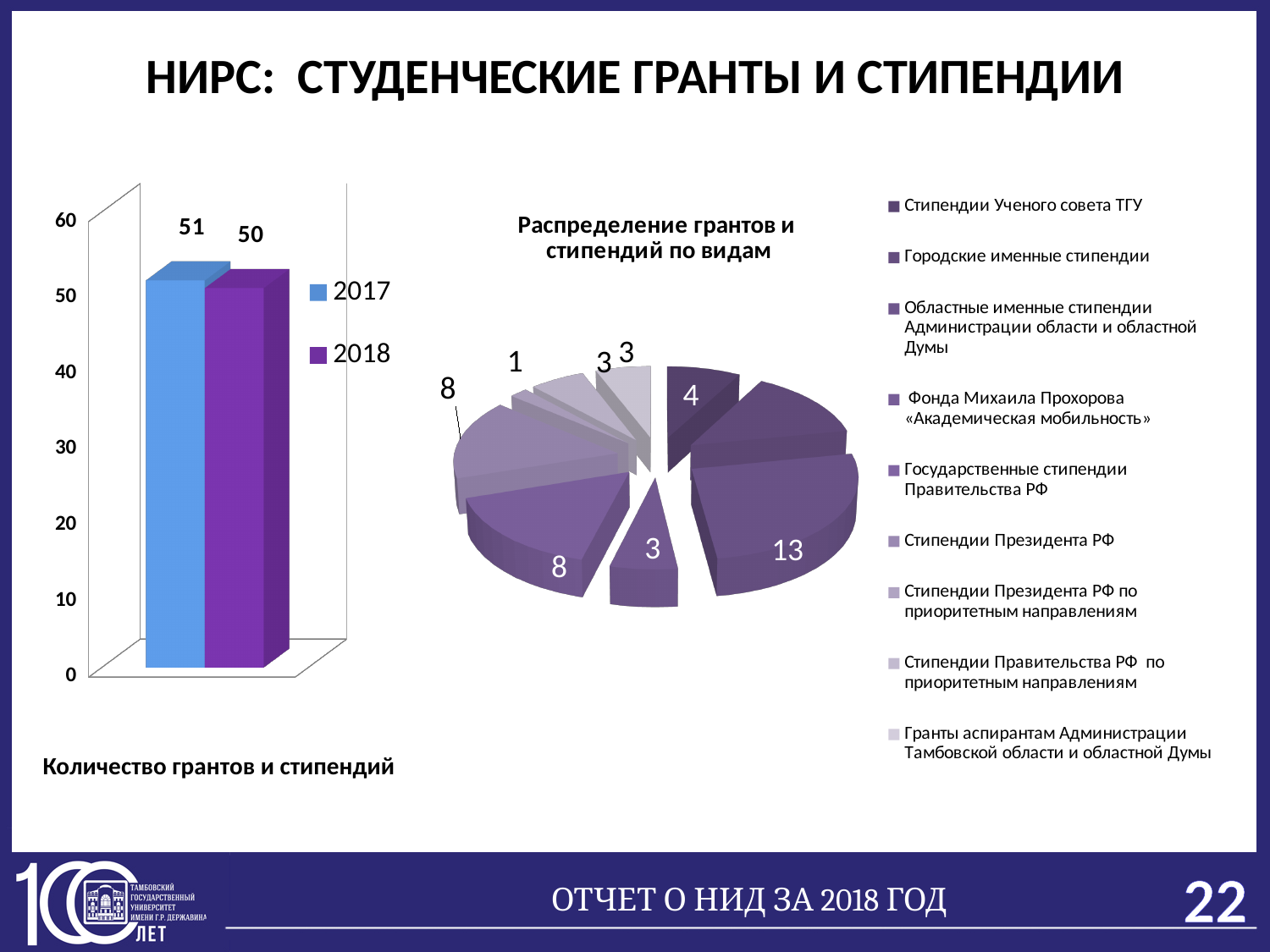
What kind of chart is 'Распределение грантов и стипендий по видам'? Pie chart On the left bar chart, which year has the higher value, 2017 or 2018? 2017 On the left bar chart, what is the difference between the 2017 and 2018 values? 1 On the left bar chart, does the value rise or fall from 2017 to 2018? Fall On the left bar chart, what is the value for 2017? 51 On the left bar chart, how many series does the legend list? 2 How many entries does the legend of the pie chart 'Распределение грантов и стипендий по видам' list? 9 What kind of chart is the chart on the left of the slide? Bar chart In the pie chart 'Распределение грантов и стипендий по видам', what is the value of the largest slice? 13 What is the caption below the left bar chart? Количество грантов и стипендий In the pie chart 'Распределение грантов и стипендий по видам', what is the value of the smallest labelled slice? 1 On the left bar chart, what is the value for 2018? 50